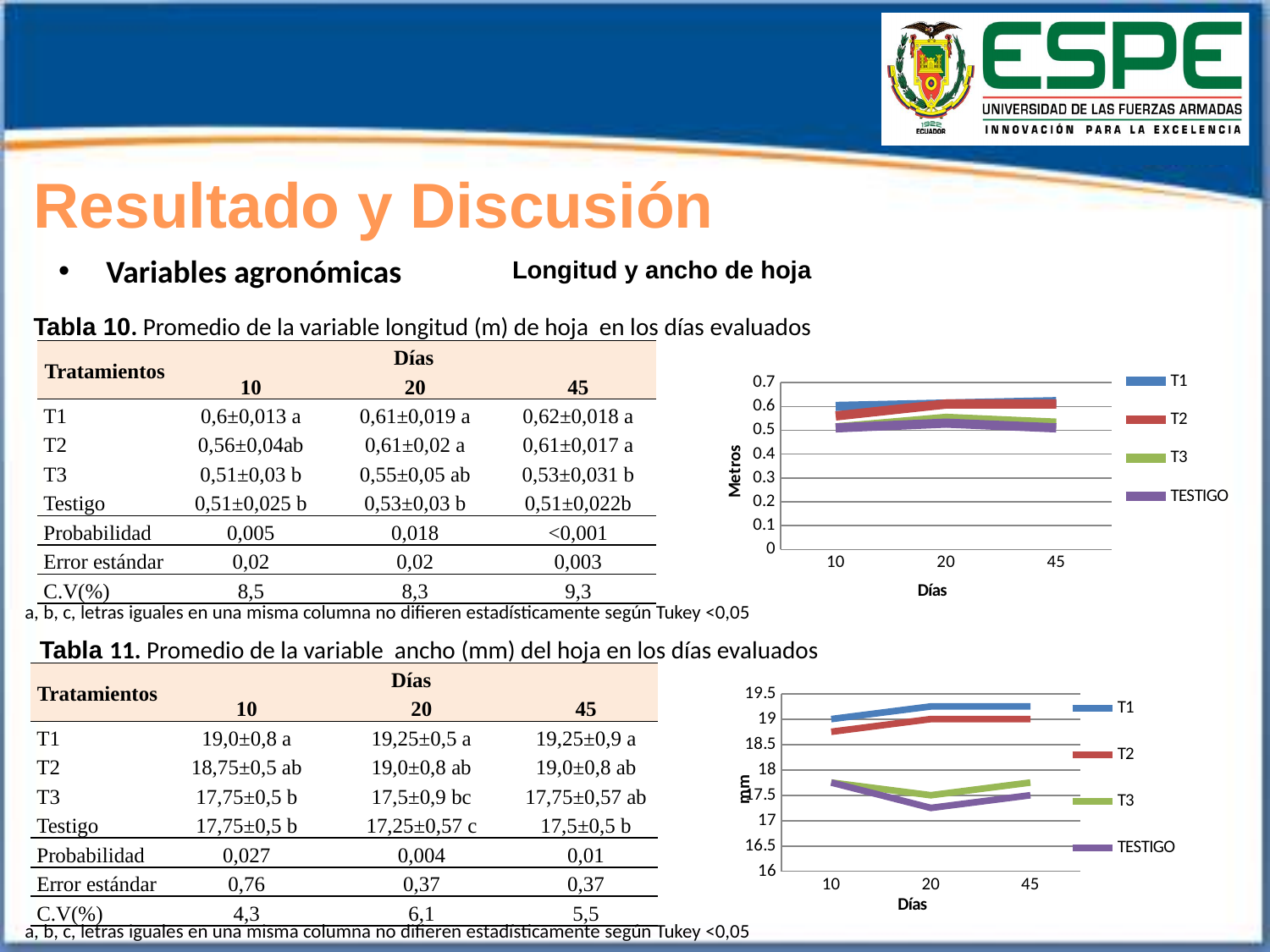
How many points are shown on the x axis of the lower chart (next to Tabla 11)? 3 In the upper chart, is the value for T1 at day 20 greater or less than 0.5? greater What is the x-axis title of the lower chart? Días In the upper chart, is the value for TESTIGO at day 45 greater or less than 0.6? less In the upper chart, is the value for T3 at day 10 greater or less than 0.6? less What kind of chart is the upper chart (next to Tabla 10)? line chart In the lower chart, which is larger at day 20: T1 or T3? T1 What is the y-axis title of the upper chart? Metros How many series does the legend of the upper chart list? 4 In the lower chart, does the TESTIGO line rise or fall from day 10 to day 20? fall